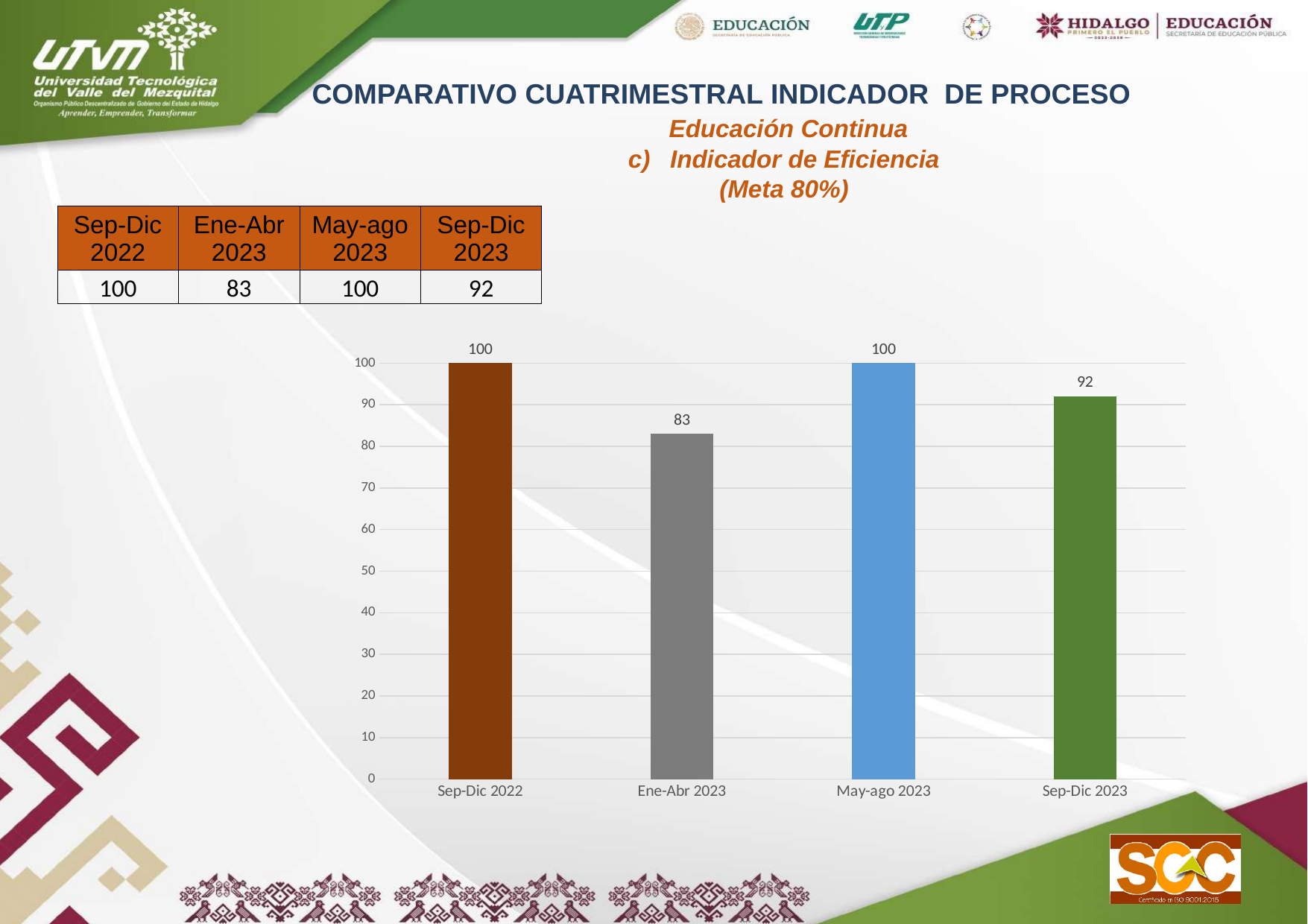
What is the difference between the values for Sep-Dic 2023 and Ene-Abr 2023? 9 What is the difference between the values for May-ago 2023 and Sep-Dic 2023? 8 What is the value for Ene-Abr 2023? 83 Do the values rise or fall from May-ago 2023 to Sep-Dic 2023? fall Which period has the lowest value? Ene-Abr 2023 What is the value for Sep-Dic 2023? 92 Is the value for Ene-Abr 2023 greater or less than 90? less What kind of chart is shown on the slide? bar chart How many periods are shown on the x axis of the chart? 4 Which is larger, the value for Ene-Abr 2023 or the value for Sep-Dic 2023? Sep-Dic 2023 What colour is the bar for May-ago 2023? blue What is the value for May-ago 2023? 100